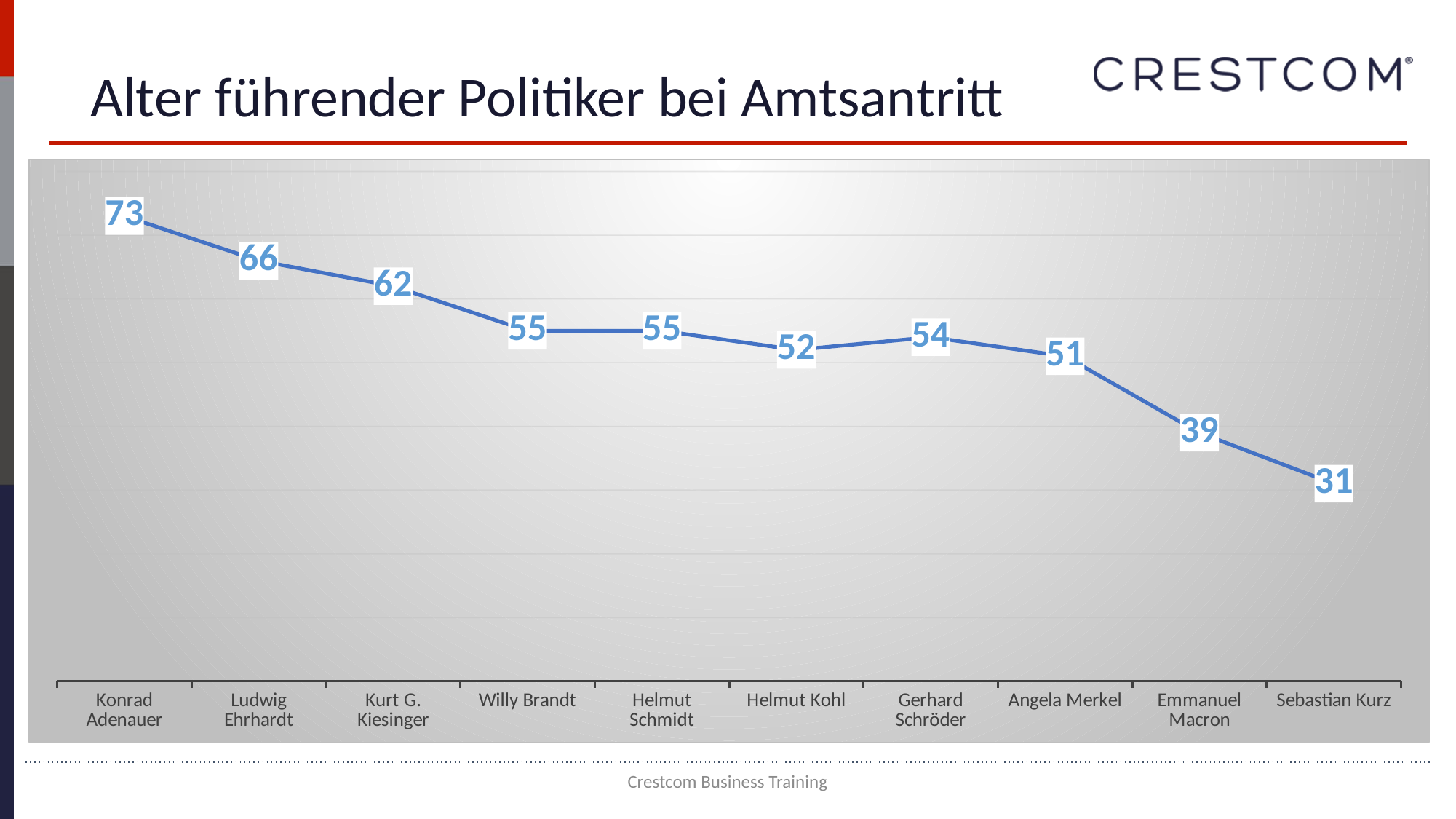
Which politician has the lowest value? Sebastian Kurz What type of chart is shown on the slide? line chart What is the difference between the values for Ludwig Ehrhardt and Kurt G. Kiesinger? 4 Which is larger, the value for Helmut Kohl or the value for Gerhard Schröder? Gerhard Schröder What is the value for Emmanuel Macron? 39 Do the values generally rise or fall from left to right along the x axis? fall What is the title of the chart on the slide? Alter führender Politiker bei Amtsantritt How many politicians are plotted on the chart? 10 What is the value for Konrad Adenauer? 73 Which politician has the highest value? Konrad Adenauer What is the difference between the values for Konrad Adenauer and Sebastian Kurz? 42 What is the value for Angela Merkel? 51